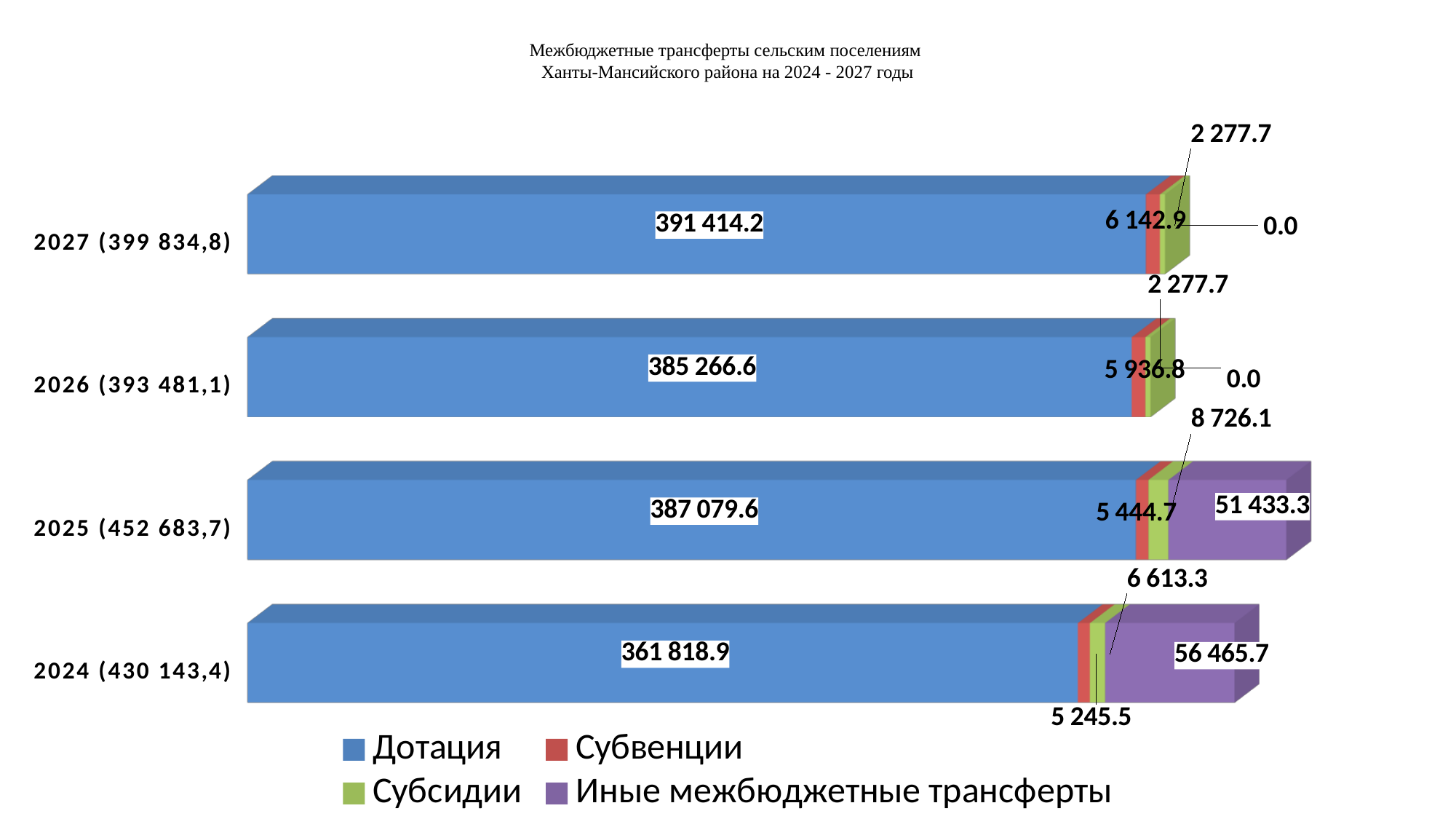
What is the value of Иные межбюджетные трансферты for 2026? 0.0 What is the total of the stacked bar for 2025, as shown in its category label? 452 683,7 What is the value of Иные межбюджетные трансферты for 2025? 51 433.3 How many series does the legend list? 4 What is the value of Дотация for 2024? 361 818.9 Which is larger: Субвенции in 2026 or Субвенции in 2027? 2027 What kind of chart is shown on the slide? bar chart Which year has the lowest value of Дотация? 2024 What is the difference between Иные межбюджетные трансферты in 2024 and in 2025? 5 032.4 What is the value of Субсидии for 2027? 2 277.7 Which year has the highest value of Дотация? 2027 How many years (categories) are plotted on the chart? 4